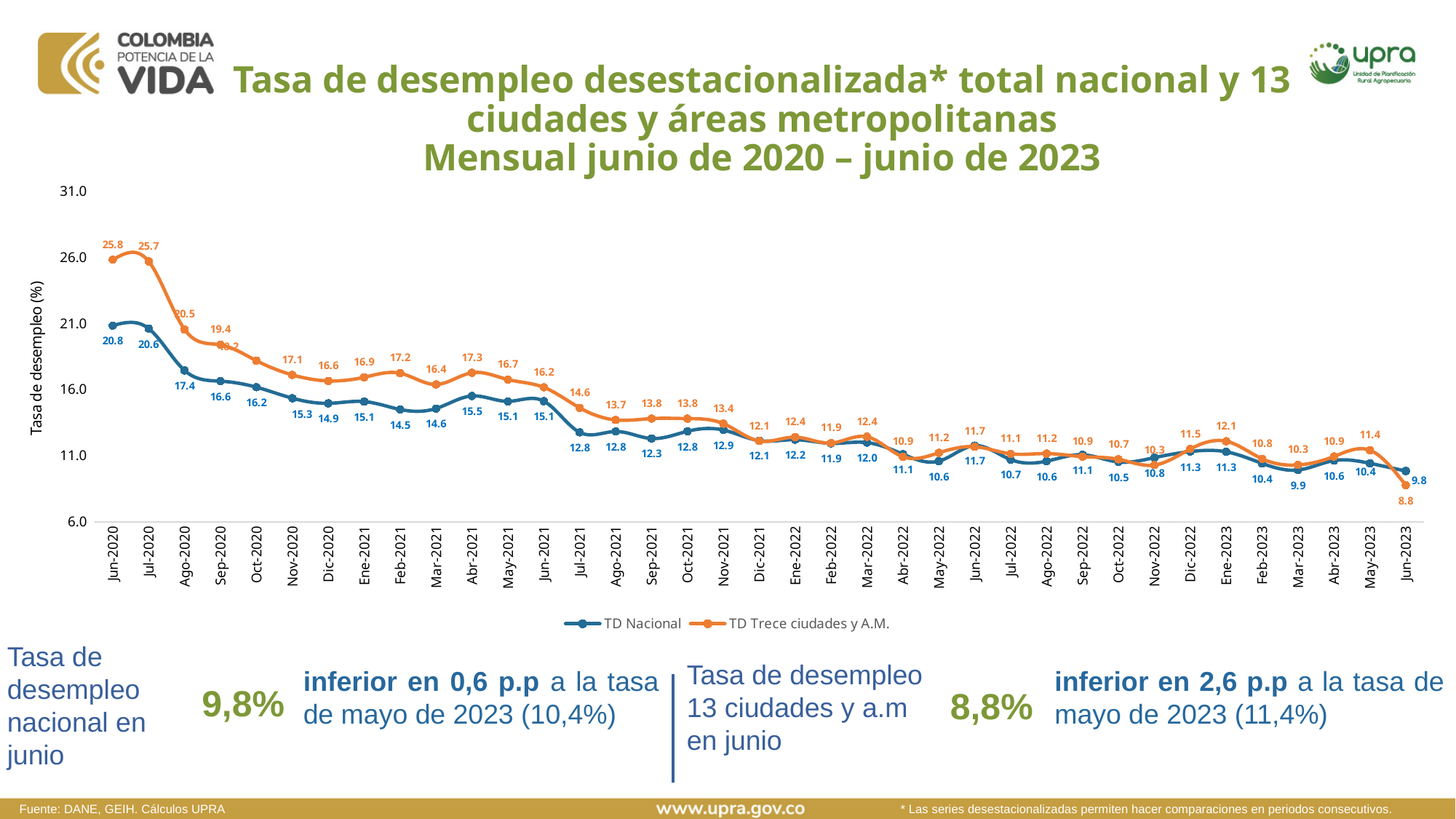
What is the value of TD Nacional in May-2023? 10.4 What is the difference between TD Trece ciudades y A.M. and TD Nacional in Jun-2020? 5.0 How many monthly data points does each series have? 37 Do the values of TD Nacional generally rise or fall from Jun-2020 to Jun-2023? fall In which month is TD Trece ciudades y A.M. at its lowest? Jun-2023 What is the value of TD Trece ciudades y A.M. in Jun-2020? 25.8 In which month is TD Trece ciudades y A.M. at its highest? Jun-2020 How many series does the legend list? 2 Is the value for TD Trece ciudades y A.M. in Jun-2020 greater or less than 21.0? greater What is the value of TD Nacional in Jun-2023? 9.8 What kind of chart is shown on the slide? line chart In Ene-2023, which series has the higher value, TD Nacional or TD Trece ciudades y A.M.? TD Trece ciudades y A.M.